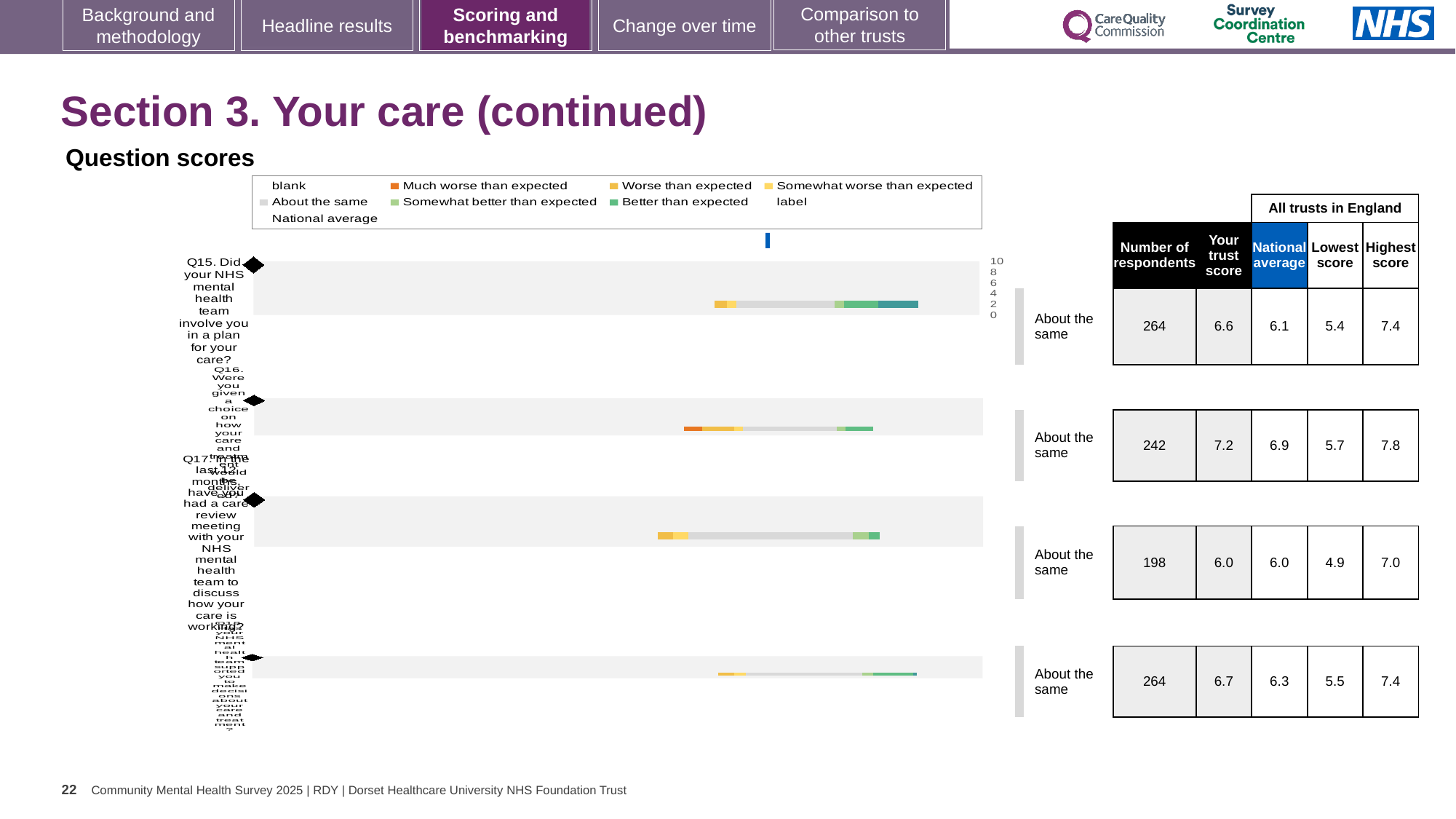
Which question has the highest trust score? Q16 Which question has the lowest number of respondents? Q17 What is the difference between the highest score and the lowest score for Q15? 2.0 What is the trust score for Q16? 7.2 How many question bars are plotted in the chart? 4 What benchmark category is shown for Q15? About the same What is the lowest score shown for the bottom row of the table? 5.5 For Q16, which is larger: the trust score or the national average? the trust score What is the number of respondents for Q15? 264 What is the national average for Q17? 6.0 How many entries does the chart legend list? 9 What kind of chart is used to show the question scores on this slide? bar chart